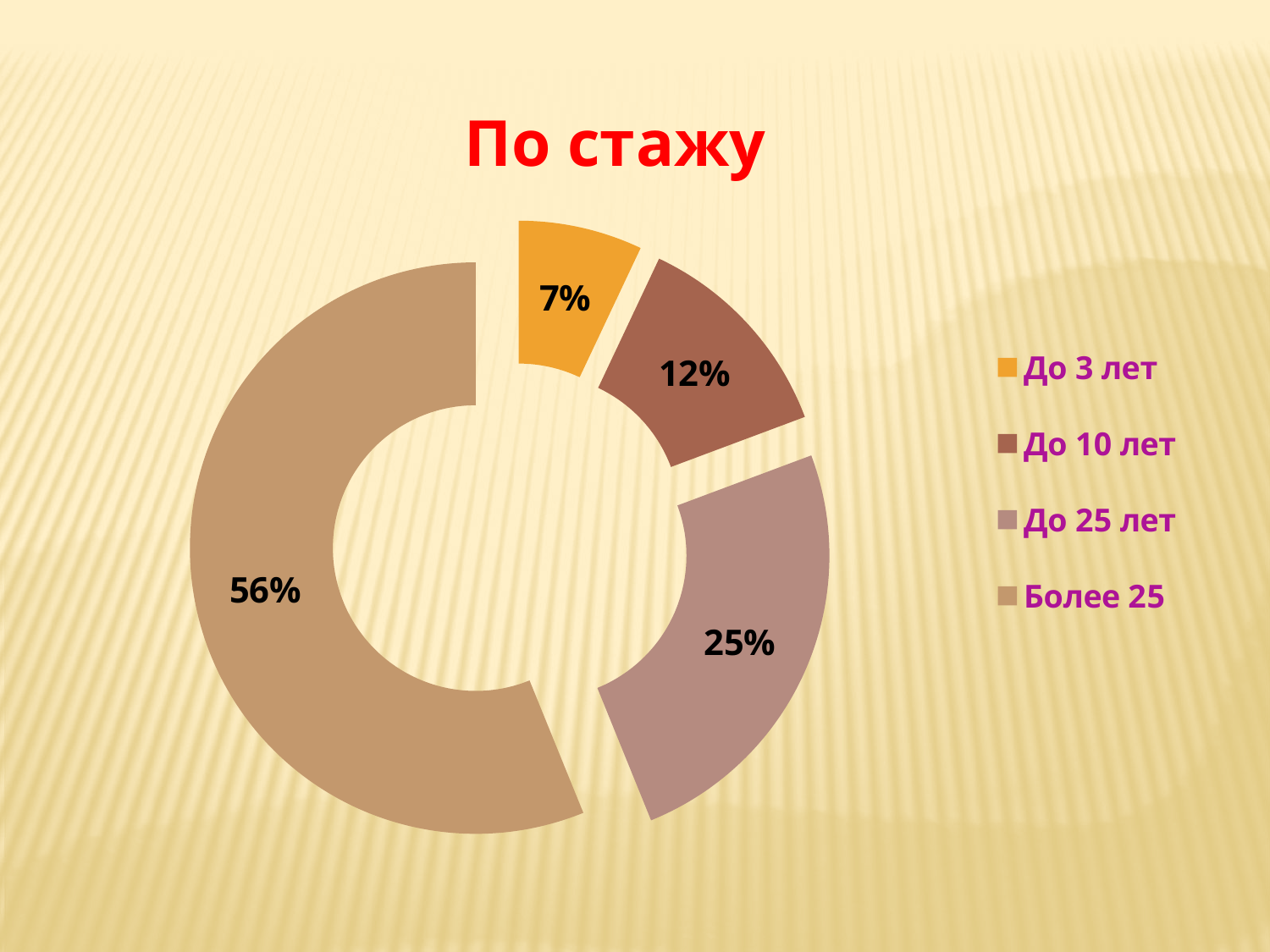
What is the difference in percentage points between 'Более 25' and 'До 25 лет'? 31 How many categories does the chart show? 4 What kind of chart is shown on the slide? Doughnut (pie) chart What share of the chart does the 'До 3 лет' slice represent? 7% What colour is the 'До 3 лет' slice? Orange Which category has the largest share? Более 25 What is the value shown for 'До 10 лет'? 12% What is the value shown for 'До 25 лет'? 25% Which category has the smallest share? До 3 лет What is the title of the chart? По стажу What is the value shown for 'Более 25'? 56% Which is larger, the share for 'До 10 лет' or for 'До 3 лет'? До 10 лет